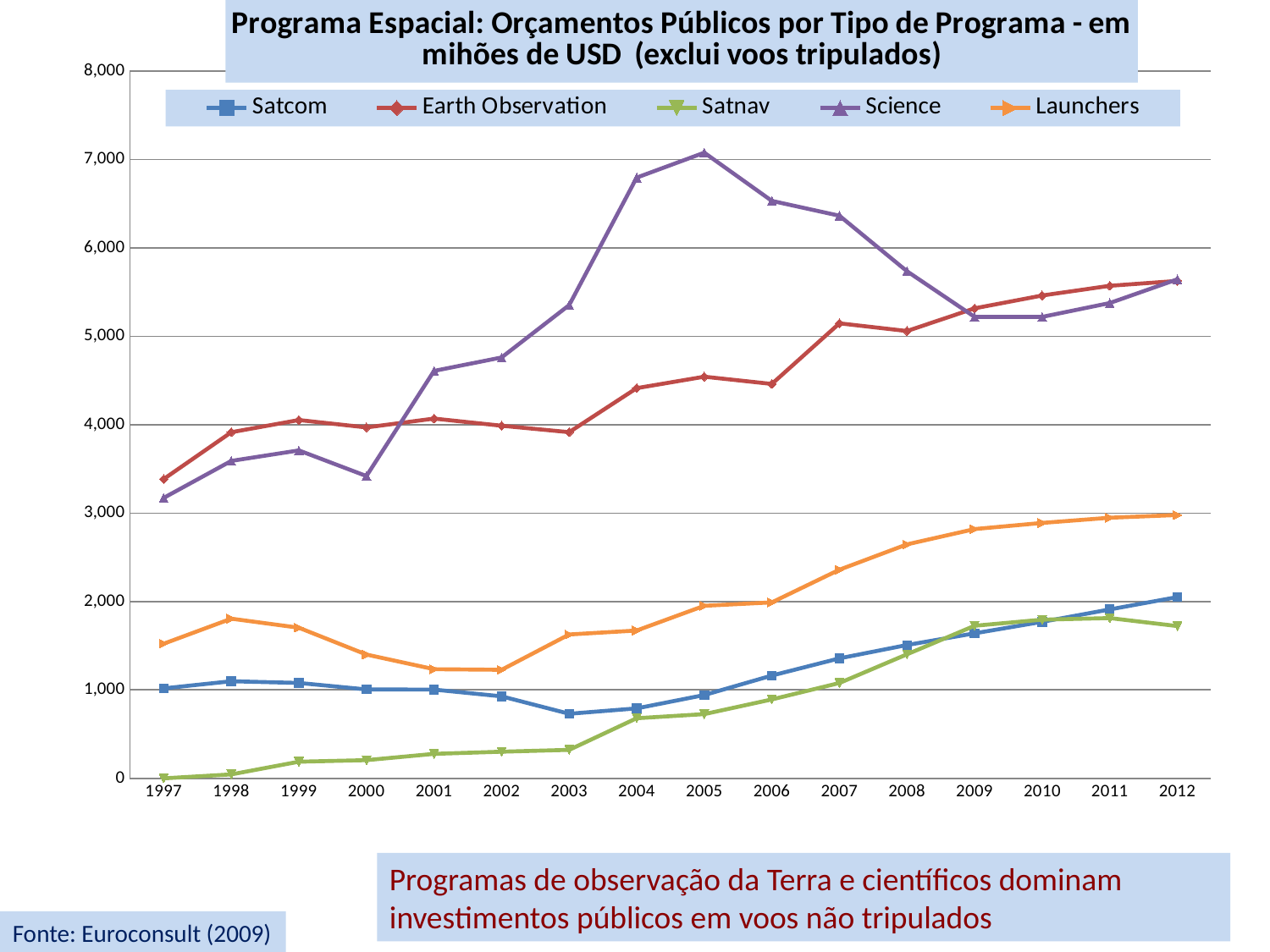
Does the Satnav series rise or fall from 1997 to 2012? rise How many series does the legend list? 5 In 2000, which is larger: Earth Observation or Science? Earth Observation What source is cited for the chart? Euroconsult (2009) What type of chart is shown on the slide? line chart Which series has the lowest value in 1997? Satnav Is the value for Satcom in 2003 greater or less than 1,000? less Is the value for Science in 2004 greater or less than 6,000? greater Is the value for Launchers in 2001 greater or less than 1,500? less How many years are shown along the x axis? 16 In which year does the Science series reach its peak? 2005 Which series has the highest value in 2005? Science